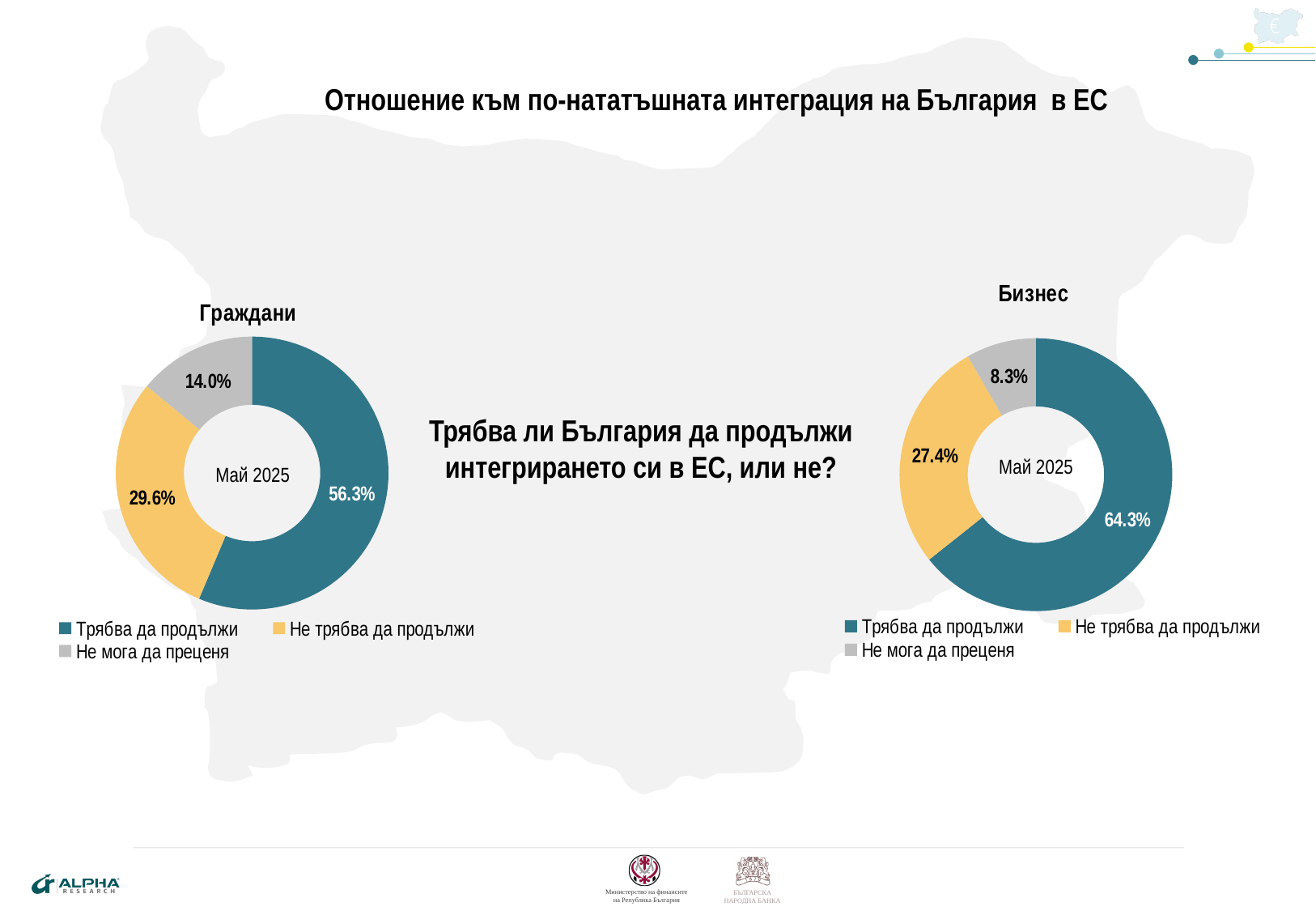
In the "Граждани" chart, what share of respondents answered "Трябва да продължи"? 56.3% In the "Бизнес" chart, what share of respondents answered "Трябва да продължи"? 64.3% How many categories does the "Бизнес" chart show? 3 In the "Граждани" chart, what is the difference between the "Трябва да продължи" and "Не трябва да продължи" shares? 26.7% In the "Граждани" chart, what share of respondents answered "Не мога да преценя"? 14.0% In the "Граждани" chart, which answer has the largest share? Трябва да продължи In the "Бизнес" chart, what share of respondents answered "Не трябва да продължи"? 27.4% In the "Бизнес" chart, which answer has the smallest share? Не мога да преценя What type of chart is the "Граждани" chart? Doughnut (pie) chart What is the difference between the "Трябва да продължи" share in the "Бизнес" chart and in the "Граждани" chart? 8.0% What text is shown in the centre of the "Бизнес" chart? Май 2025 Which chart shows a larger share for "Не мога да преценя", "Граждани" or "Бизнес"? Граждани